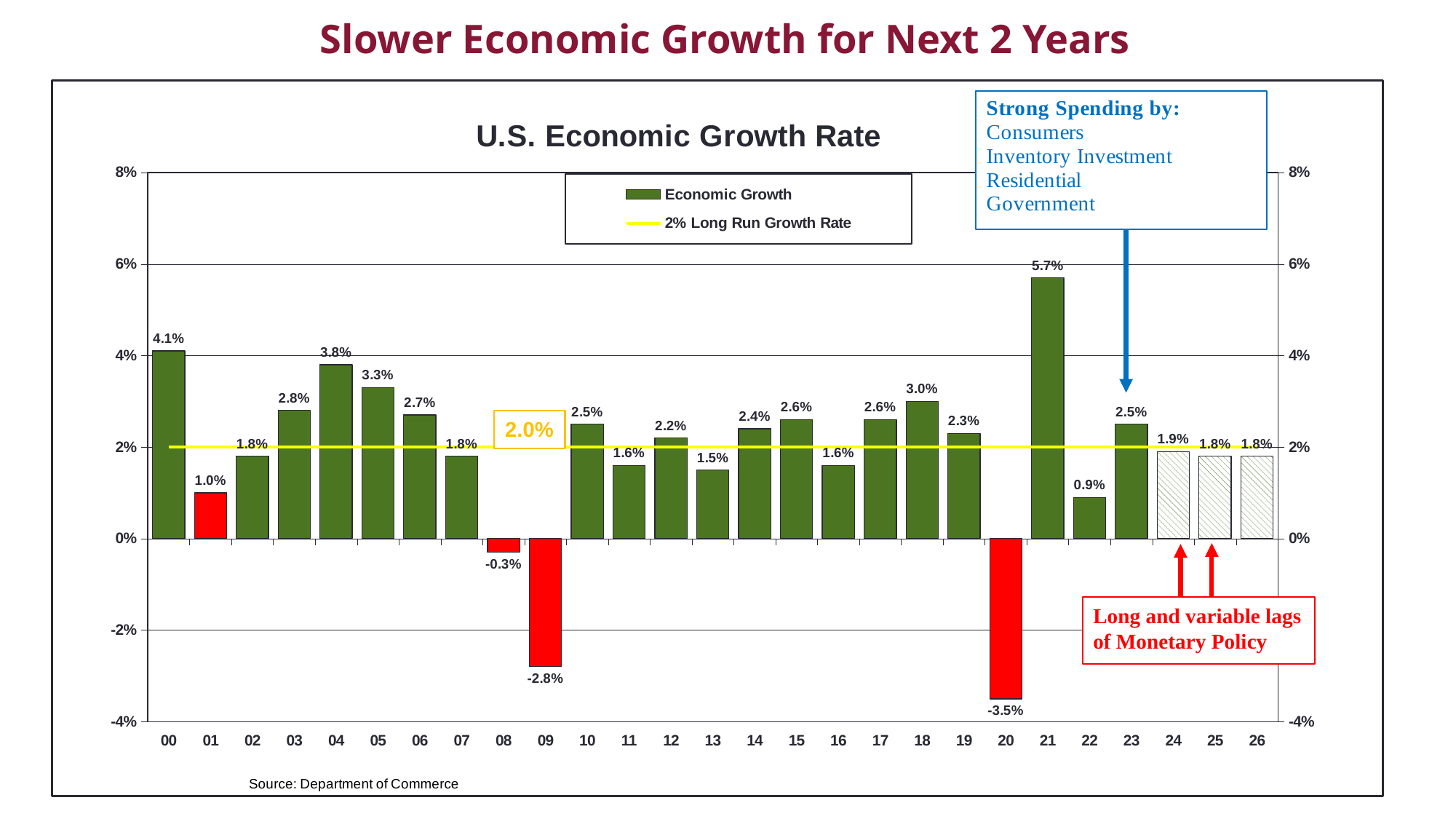
What value does the yellow horizontal line represent? 2.0% How many series does the legend list? 2 What is the economic growth rate shown for 21? 5.7% What is the economic growth rate shown for 24? 1.9% What kind of chart is used to show the economic growth rate? Bar chart Which is larger, the growth rate for 04 or the growth rate for 05? 04 Which year has the highest economic growth rate? 21 How many years are shown on the x axis? 27 What is the difference between the growth rate for 00 and the growth rate for 01? 3.1% What is the title of the chart? U.S. Economic Growth Rate Which year has the lowest economic growth rate? 20 What is the economic growth rate shown for 09? -2.8%